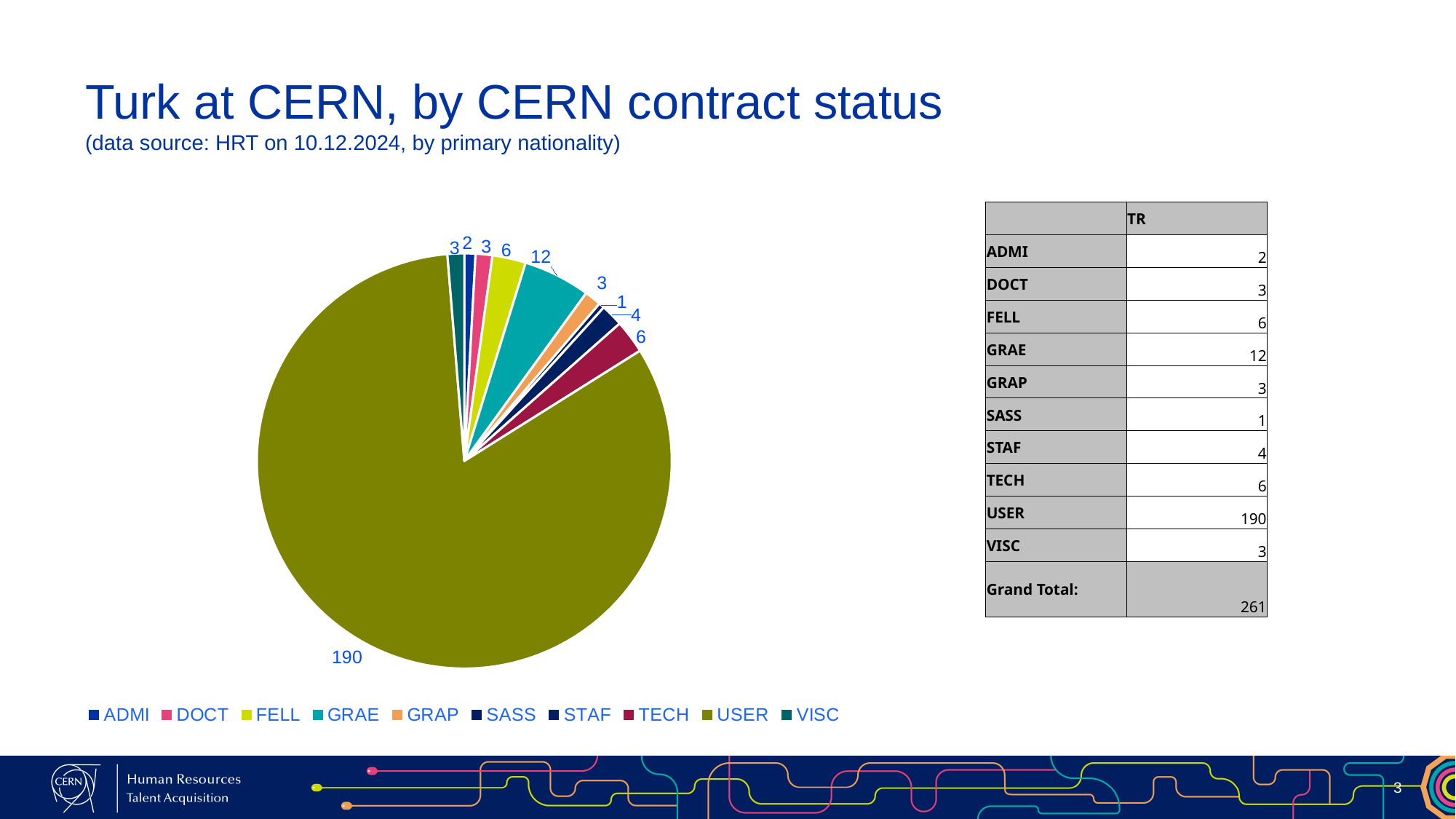
Which category has the largest slice in the pie chart? USER What is the value for STAF in the pie chart? 4 How many categories does the pie chart show? 10 What is the total of all slices in the pie chart? 261 What is the value for USER in the pie chart? 190 What is the difference between the values for USER and GRAE? 178 What is the difference between the values for FELL and ADMI? 4 What is the value for GRAE in the pie chart? 12 What is the title of the slide containing the pie chart? Turk at CERN, by CERN contract status What type of chart is shown on the slide? pie chart Which category has the smallest slice in the pie chart? SASS Which is larger, the value for GRAE or the value for TECH? GRAE